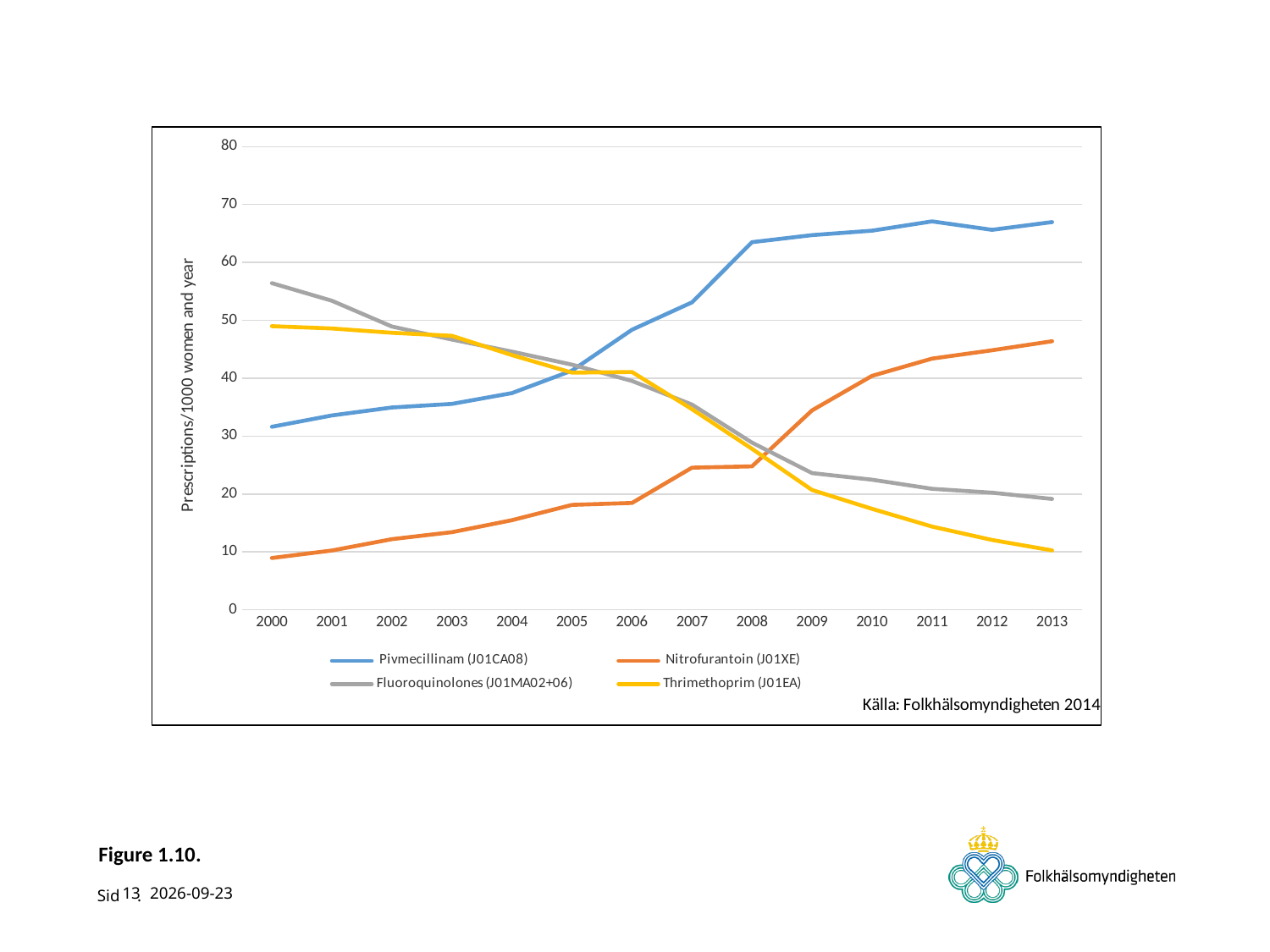
Which series has the lowest value in 2000? Nitrofurantoin (J01XE) Does the Pivmecillinam (J01CA08) line rise or fall from 2000 to 2013? rise Which series has the highest value in 2013? Pivmecillinam (J01CA08) How many years are plotted along the x axis? 14 In 2013, which is larger: Nitrofurantoin (J01XE) or Fluoroquinolones (J01MA02+06)? Nitrofurantoin (J01XE) Which series has the highest value in 2000? Fluoroquinolones (J01MA02+06) Is the value for Pivmecillinam (J01CA08) in 2013 greater or less than 60? greater Does the Thrimethoprim (J01EA) line rise or fall from 2000 to 2013? fall What kind of chart is shown on the slide? line chart Is the value for Thrimethoprim (J01EA) in 2010 greater or less than 20? less What is the label of the y axis? Prescriptions/1000 women and year How many series does the legend list? 4